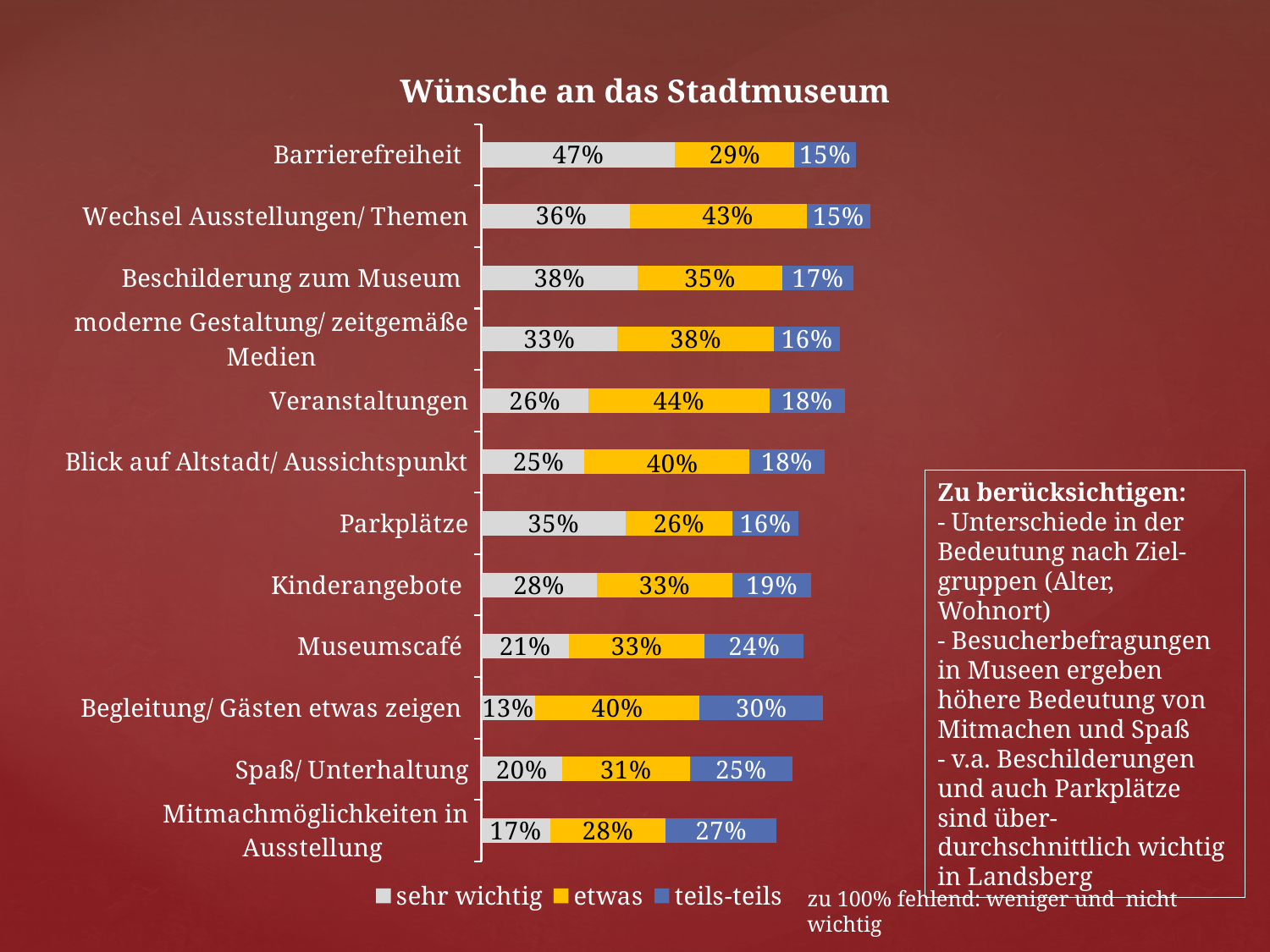
Which category has the highest 'sehr wichtig' value? Barrierefreiheit How many series does the legend list? 3 What type of chart is shown on the slide? Stacked bar chart What is the 'sehr wichtig' value for Museumscafé? 21% What is the difference between the 'sehr wichtig' values for Barrierefreiheit and Parkplätze? 12% What is the 'etwas' value for Veranstaltungen? 44% What is the 'sehr wichtig' value for Barrierefreiheit? 47% Which category has the lowest 'sehr wichtig' value? Begleitung/ Gästen etwas zeigen What is the 'teils-teils' value for Begleitung/ Gästen etwas zeigen? 30% How many categories are shown in the chart? 12 What is the total of the three segments for the Barrierefreiheit bar? 91% Which is larger: the 'etwas' value for Wechsel Ausstellungen/ Themen or for Beschilderung zum Museum? Wechsel Ausstellungen/ Themen